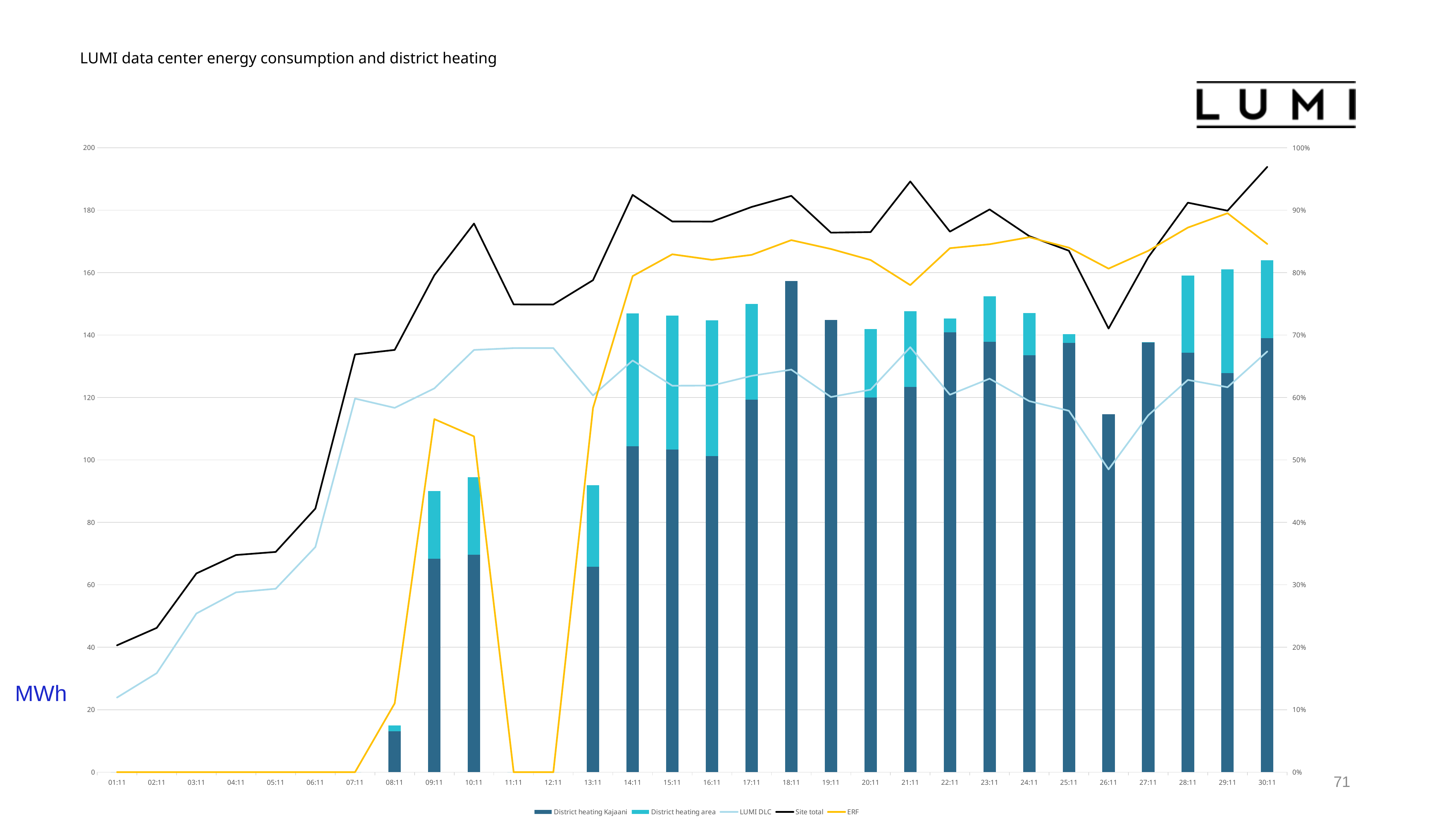
What kind of chart is this? Combination stacked bar and line chart On which date is the Site total line at its lowest? 01:11 Which is larger, the Site total at 10:11 or at 11:11? 10:11 What is the title of the chart? LUMI data center energy consumption and district heating Does the Site total line rise or fall from 01:11 to 07:11? rise Is the District heating Kajaani value at 18:11 greater or less than 140? greater How many dates are shown along the x axis? 30 On which date is the LUMI DLC line at its lowest? 01:11 Is the ERF value at 29:11 greater or less than 80%? greater How many series does the legend list? 5 Is the Site total value at 14:11 greater or less than 180? greater On which date is the Site total line at its highest? 30:11